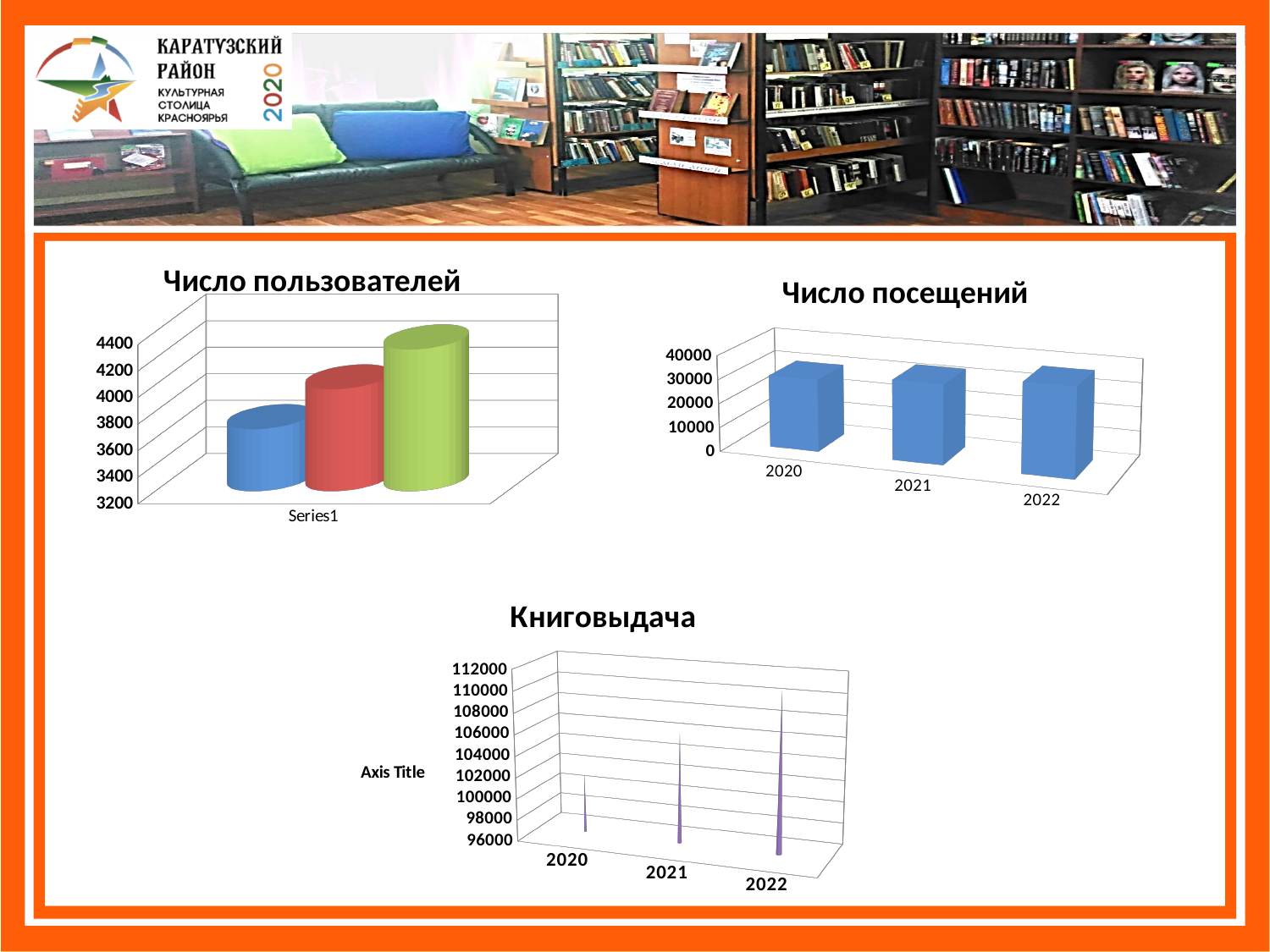
In the "Книговыдача" chart, which year has the highest value? 2022 What kind of chart is the "Число пользователей" chart? bar chart In the "Число пользователей" chart, what label is shown on the horizontal axis? Series1 In the "Книговыдача" chart, which year has the lowest value? 2020 How many bars are plotted in the "Число пользователей" chart? 3 How many categories are shown on the x axis of the "Число посещений" chart? 3 In the "Книговыдача" chart, do the values rise or fall from 2020 to 2022? rise In the "Число посещений" chart, is the value for 2022 greater or less than 40000? less In the "Число пользователей" chart, do the values rise or fall from left to right? rise In the "Книговыдача" chart, is the value for 2020 greater or less than 104000? less In the "Число посещений" chart, is the value for 2020 greater or less than 10000? greater In the "Число пользователей" chart, which bar is the tallest: the blue, the red or the green one? green